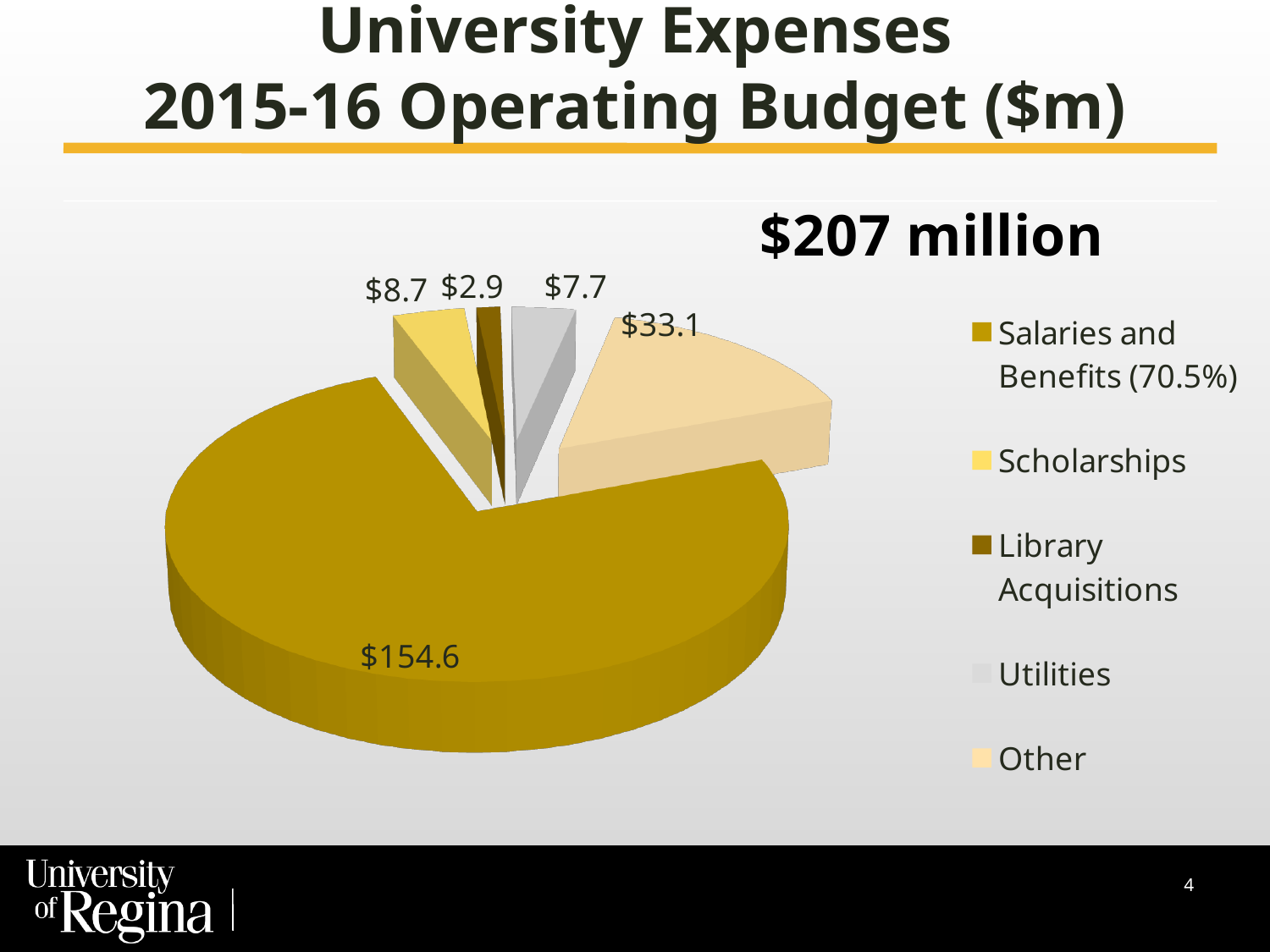
What share of the pie does Salaries and Benefits represent? 70.5% How many categories does the pie chart show? 5 What is the value for Other? $33.1 What is the value for Utilities? $7.7 What is the difference between Salaries and Benefits and Other? $121.5 Which category has the smallest slice? Library Acquisitions What is the value for Salaries and Benefits? $154.6 Which is larger, Scholarships or Utilities? Scholarships Which category has the largest slice? Salaries and Benefits What is the value for Library Acquisitions? $2.9 What kind of chart is shown on the slide? Pie chart What is the value for Scholarships? $8.7